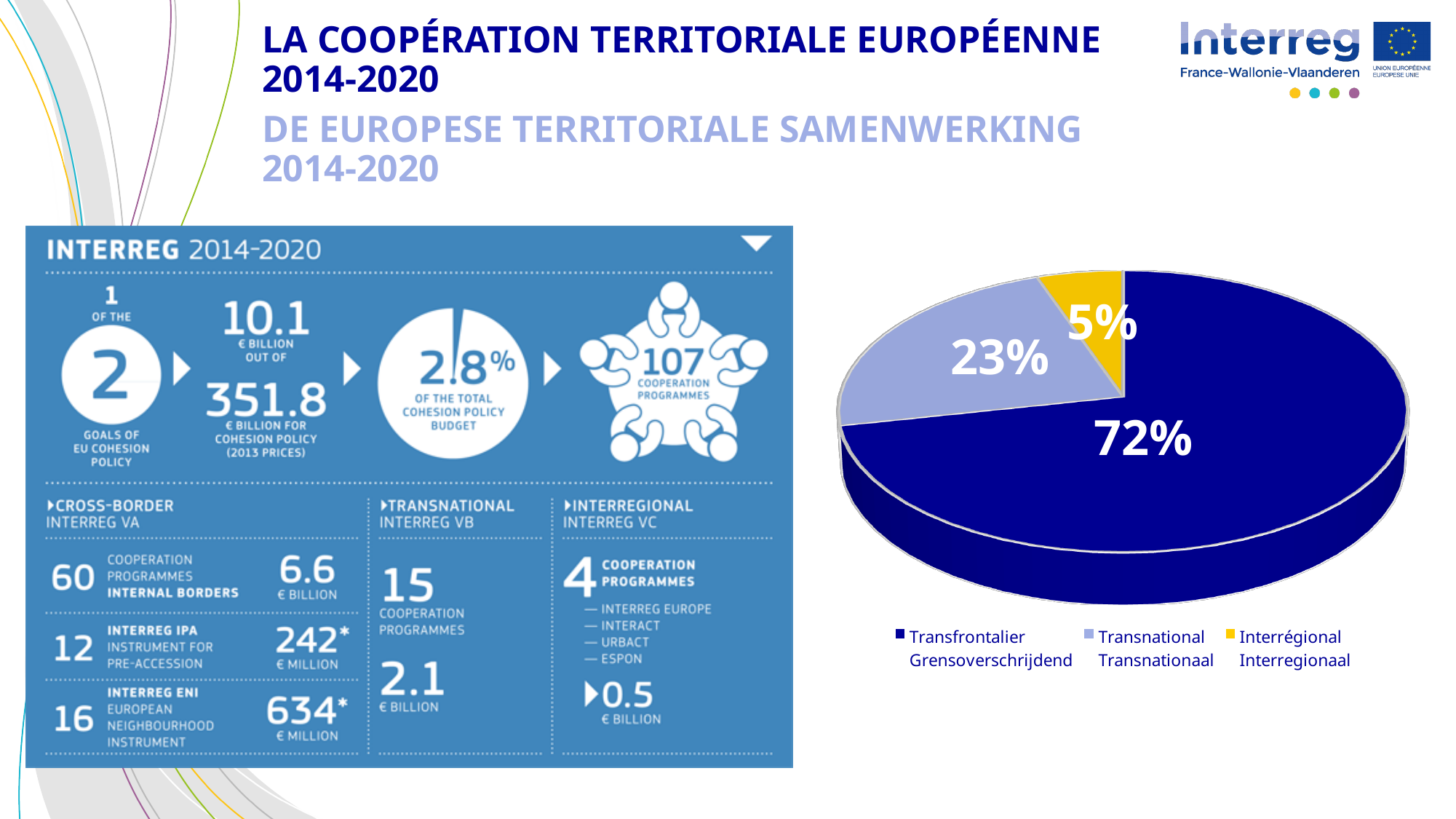
How many slices does the pie chart have? 3 How many entries does the pie chart's legend list? 3 Which category has the smallest slice in the pie chart? Interrégional / Interregionaal What share of the pie chart does Transnational / Transnationaal represent? 23% Which is larger in the pie chart: Transnational or Interrégional? Transnational What share of the pie chart does Interrégional / Interregionaal represent? 5% What is the difference in percentage points between the Transfrontalier slice and the Transnational slice? 49 What share of the pie chart does Transfrontalier / Grensoverschrijdend represent? 72% Which category has the largest slice in the pie chart? Transfrontalier / Grensoverschrijdend What colour is the Interrégional / Interregionaal slice in the pie chart? Yellow What is the difference in percentage points between the Transnational slice and the Interrégional slice? 18 What type of chart is shown on the right side of the slide? Pie chart